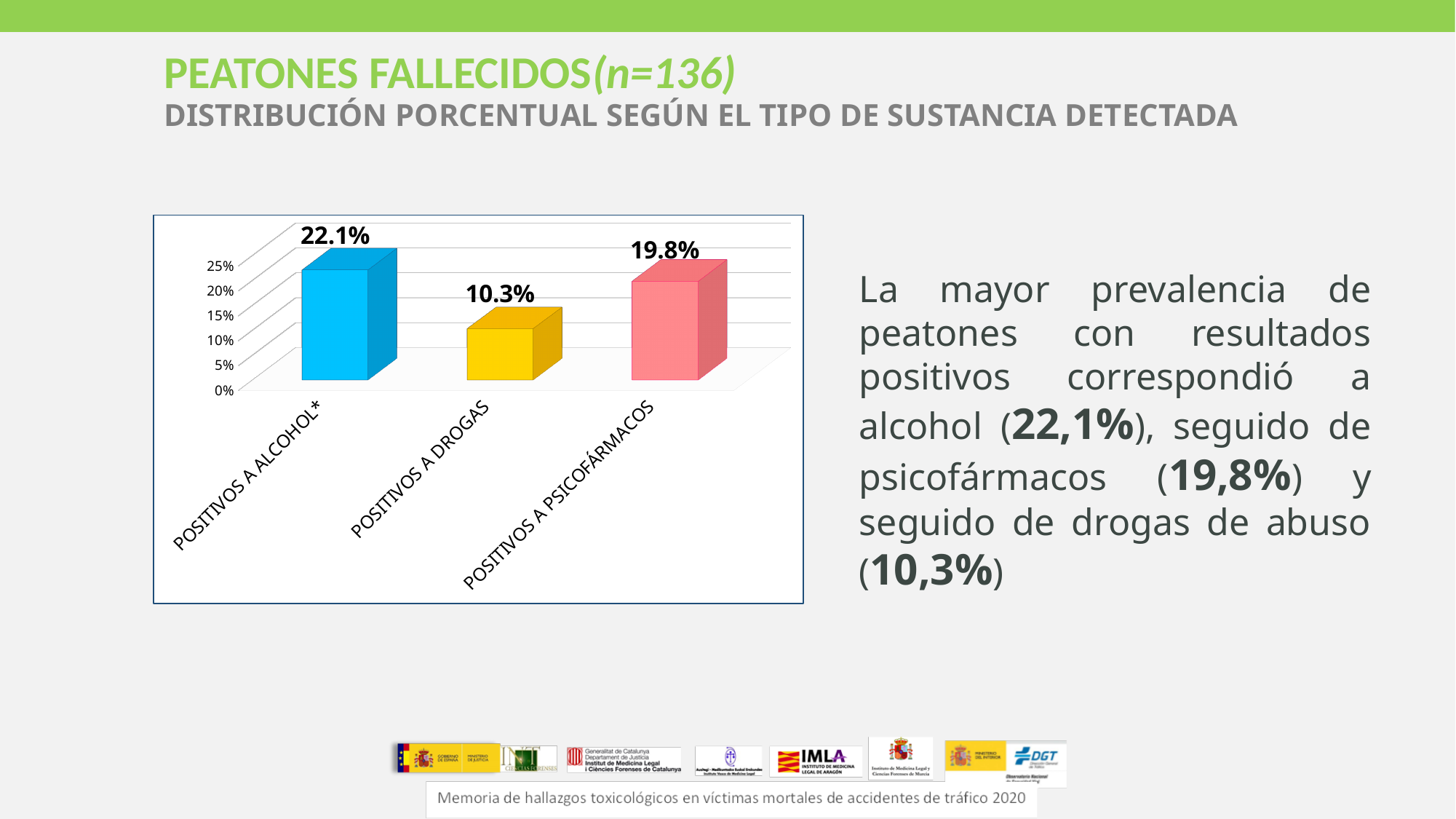
Is the value for POSITIVOS A DROGAS greater or less than 15%? less Which is larger, the value for POSITIVOS A DROGAS or the value for POSITIVOS A PSICOFÁRMACOS? POSITIVOS A PSICOFÁRMACOS How many categories are shown in the chart? 3 What is the value for POSITIVOS A PSICOFÁRMACOS? 19.8% What is the difference between the values for POSITIVOS A ALCOHOL* and POSITIVOS A DROGAS? 11.8% What is the difference between the values for POSITIVOS A ALCOHOL* and POSITIVOS A PSICOFÁRMACOS? 2.3% Which category has the lowest value? POSITIVOS A DROGAS What kind of chart is shown on the slide? bar chart Which category has the highest value? POSITIVOS A ALCOHOL* What is the value for POSITIVOS A DROGAS? 10.3% What colour is the bar for POSITIVOS A DROGAS? yellow What is the value for POSITIVOS A ALCOHOL*? 22.1%